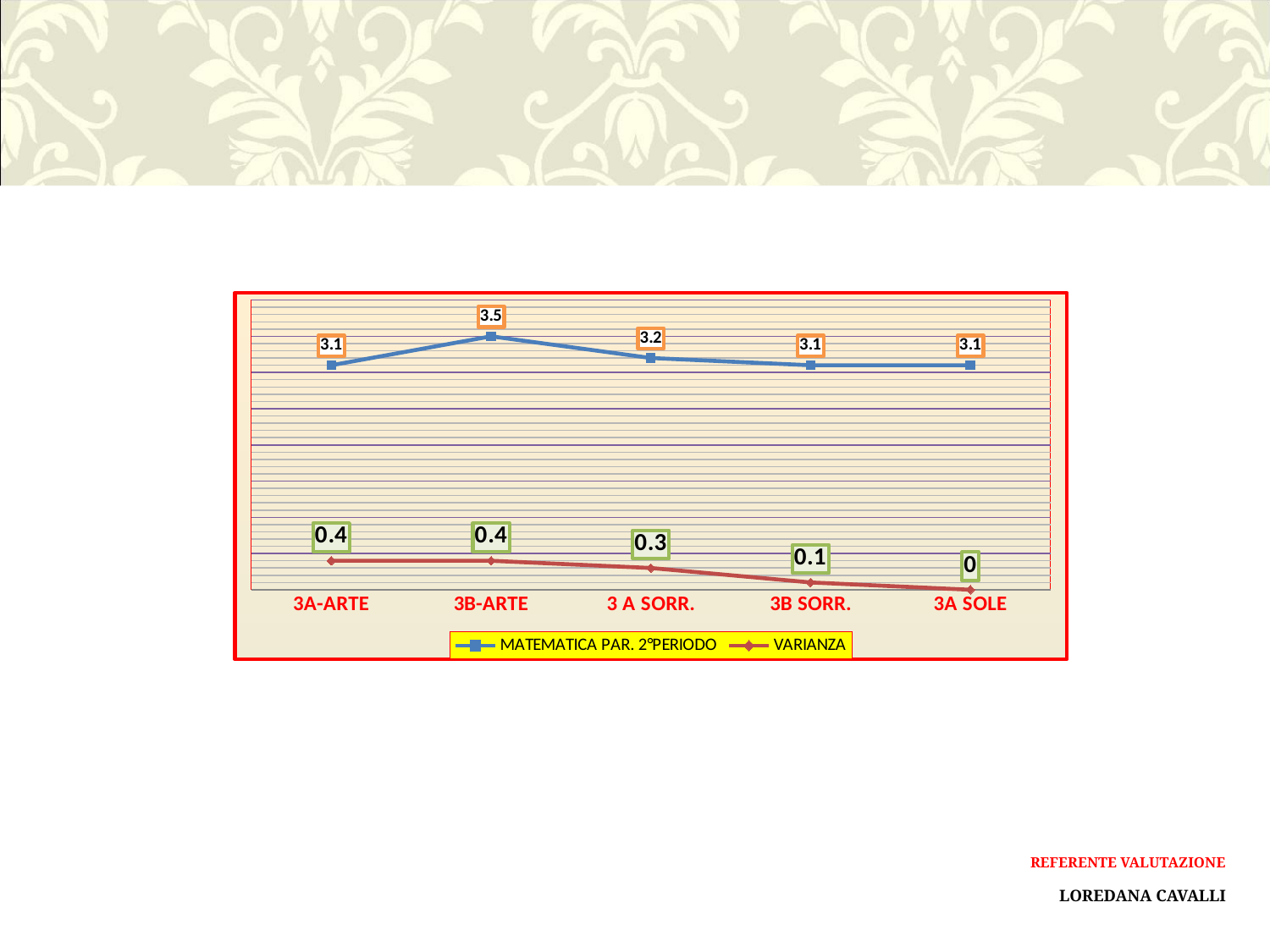
Which category has the highest MATEMATICA PAR. 2°PERIODO value? 3B-ARTE What is the VARIANZA value for 3 A SORR.? 0.3 How many series does the legend list? 2 How many categories are shown on the x axis? 5 What kind of chart is shown on the slide? Line chart Does the VARIANZA series rise or fall from 3B-ARTE to 3A SOLE? Fall What is the VARIANZA value for 3A SOLE? 0 Which category has the lowest VARIANZA value? 3A SOLE What is the MATEMATICA PAR. 2°PERIODO value for 3B-ARTE? 3.5 What is the MATEMATICA PAR. 2°PERIODO value for 3 A SORR.? 3.2 Which is larger, the VARIANZA value for 3B-ARTE or for 3B SORR.? 3B-ARTE What is the difference between the MATEMATICA PAR. 2°PERIODO values for 3B-ARTE and 3A-ARTE? 0.4